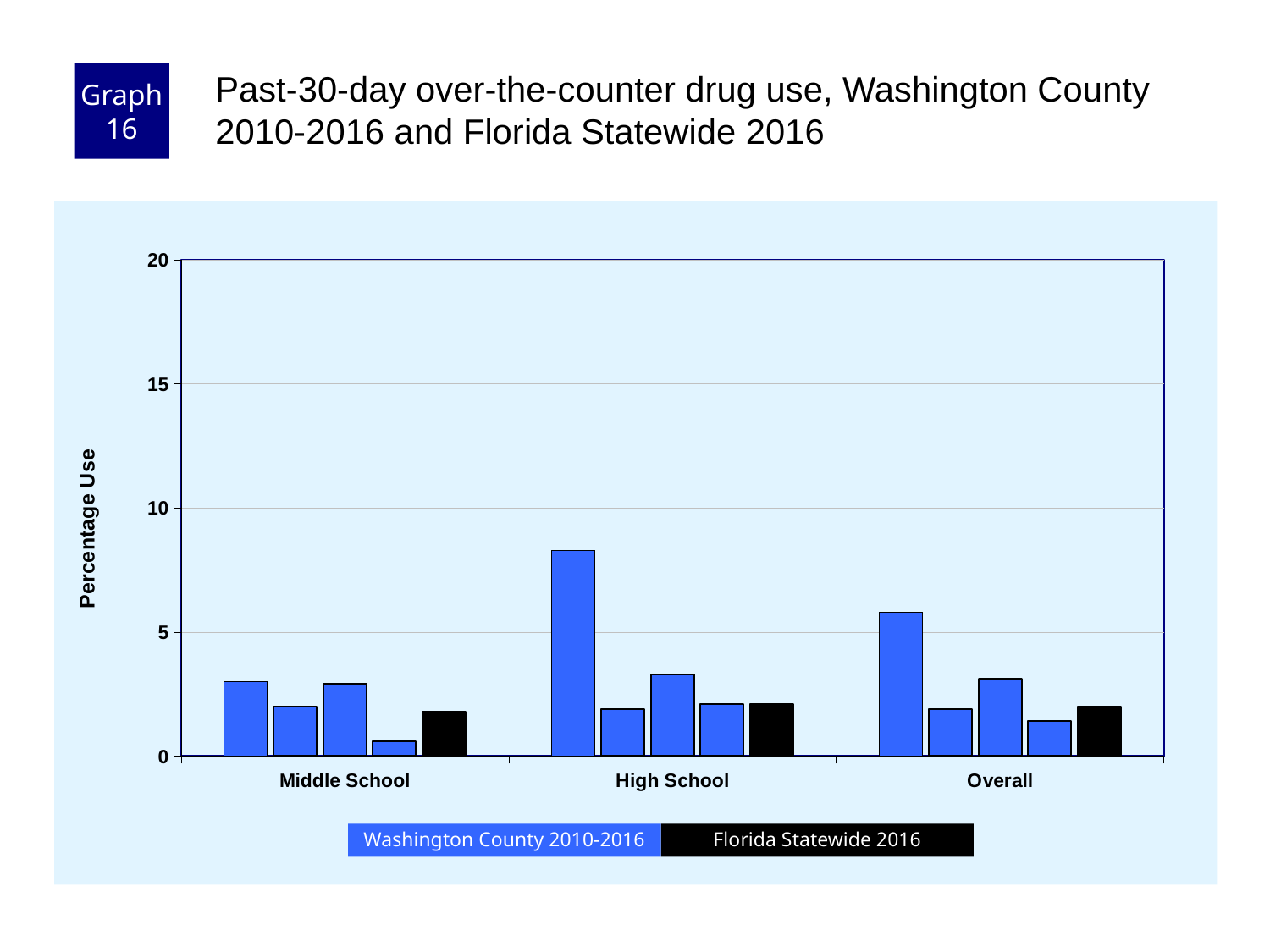
Is the Florida Statewide 2016 value for Overall greater or less than 5? less Which is larger: the tallest bar in the High School group or the tallest bar in the Overall group? High School Is the tallest bar in the High School group greater or less than 5? greater What is the label of the y axis? Percentage Use In the Overall group, which is larger: the Florida Statewide 2016 bar or the tallest Washington County 2010-2016 bar? Washington County 2010-2016 Is the tallest bar in the Overall group greater or less than 5? greater How many category groups are shown along the x axis? 3 What kind of chart is shown on the slide? Bar chart How many series does the legend list? 2 Which colour represents Florida Statewide 2016 in the legend? Black Which category group contains the tallest bar in the chart? High School